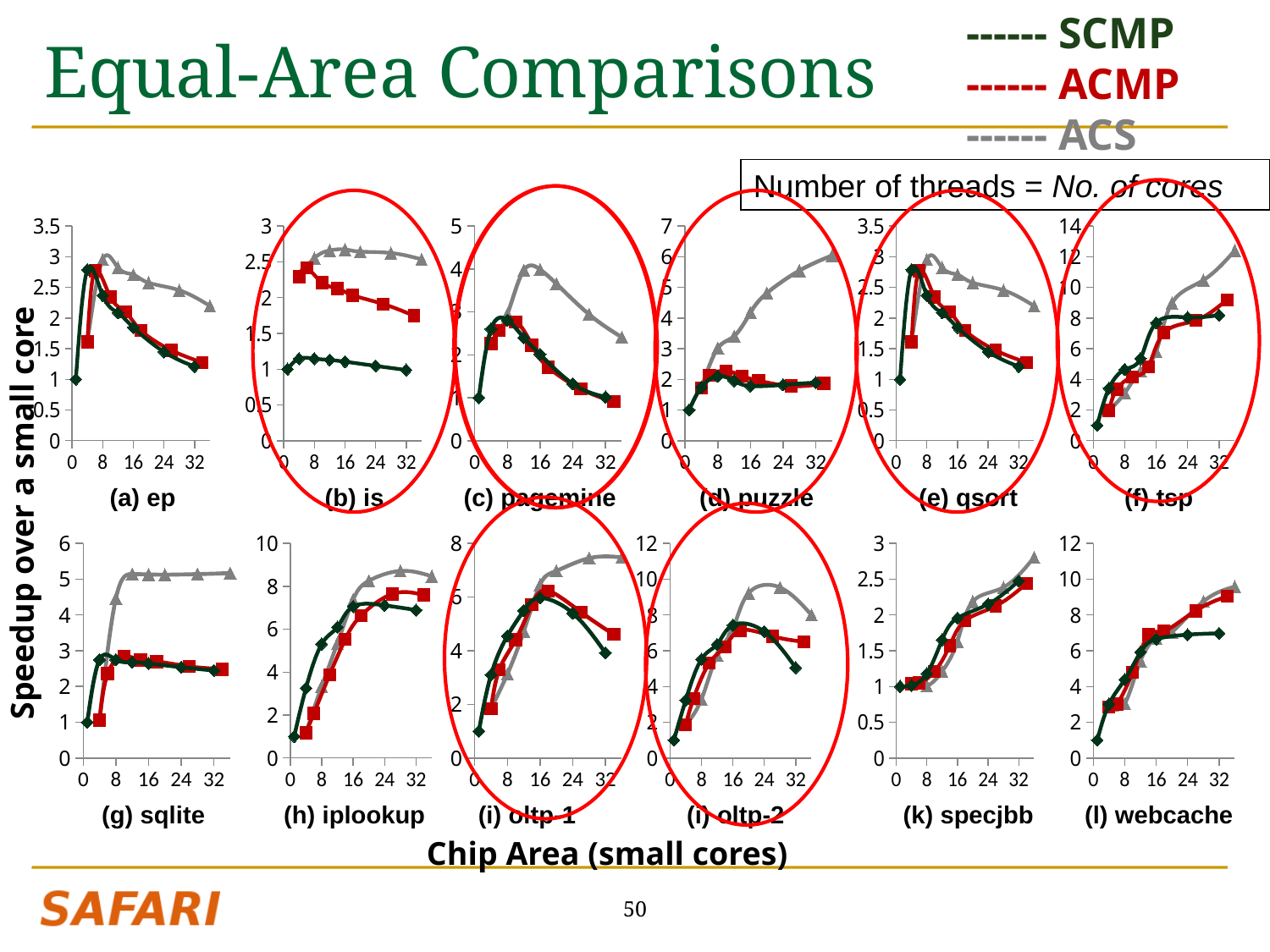
In the (b) is panel, is the ACS value at chip area 16 greater or less than 2.5? greater In the (l) webcache panel, which series is higher at chip area 32, ACMP or SCMP? ACMP How many chart panels are shown on the slide? 12 What kind of chart is used in the (a) ep panel? line chart What is the title of the slide? Equal-Area Comparisons In the (g) sqlite panel, is the ACS value at chip area 32 greater or less than 4? greater In the (f) tsp panel, is the ACS value at chip area 32 greater or less than 10? greater In the (d) puzzle panel, does the ACS line rise or fall as chip area increases from 0 to 32? rises How many series does the legend list? 3 In the (d) puzzle panel, which series is higher at chip area 32, ACS or SCMP? ACS What is the shared x-axis label of the charts? Chip Area (small cores)